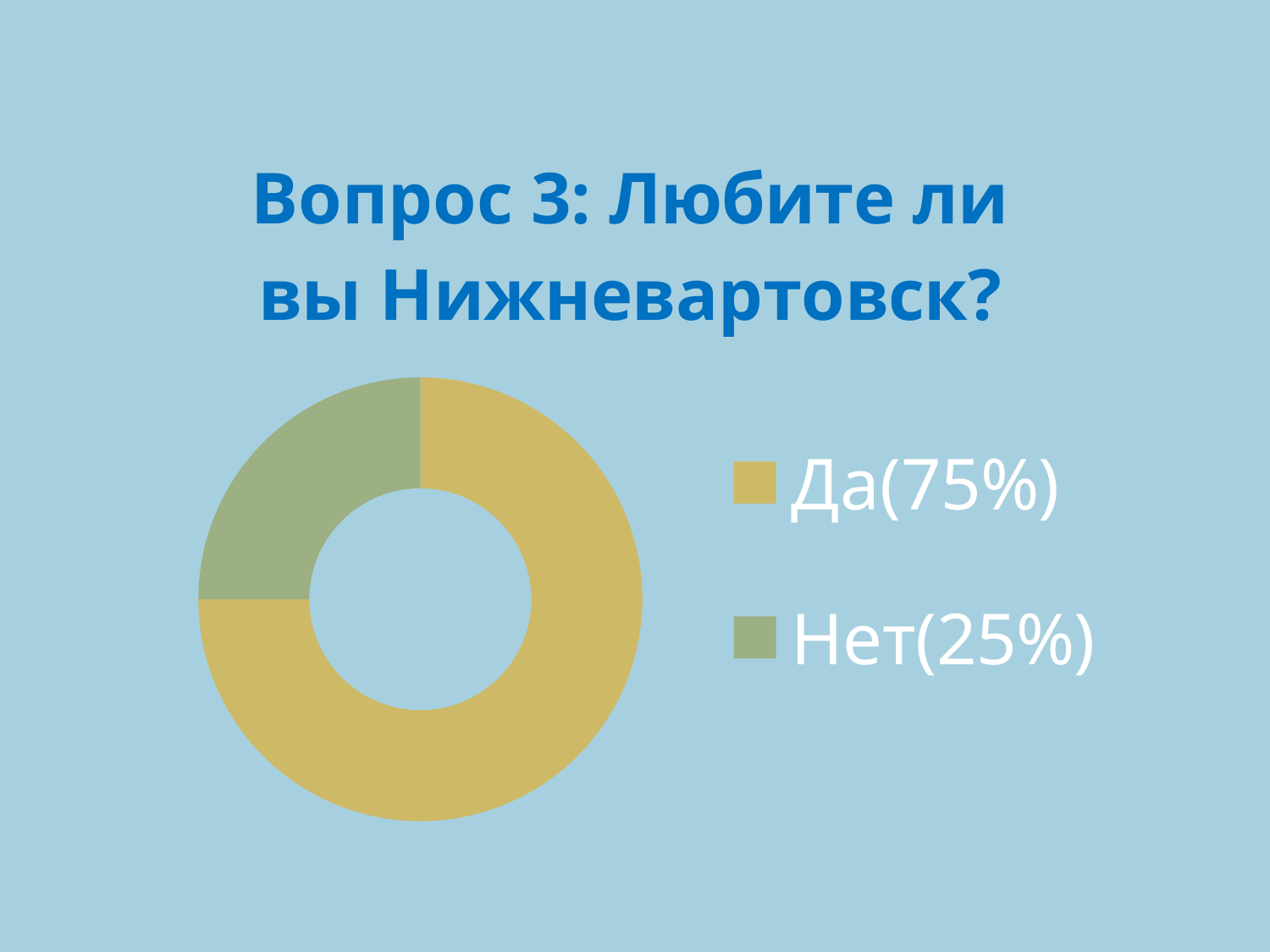
What kind of chart is shown on the slide? Doughnut (pie) chart Which answer has the smallest share? Нет Which answer has the largest share? Да What share of respondents answered "Да"? 75% Which is larger, the share for "Да" or for "Нет"? Да How many entries does the legend list? 2 Is the share for "Да" greater or less than 50%? greater What is the difference in percentage points between "Да" and "Нет"? 50 What share of respondents answered "Нет"? 25% How many categories does the chart show? 2 What is the title of the slide above the chart? Вопрос 3: Любите ли вы Нижневартовск? What colour is the "Нет" slice? Green